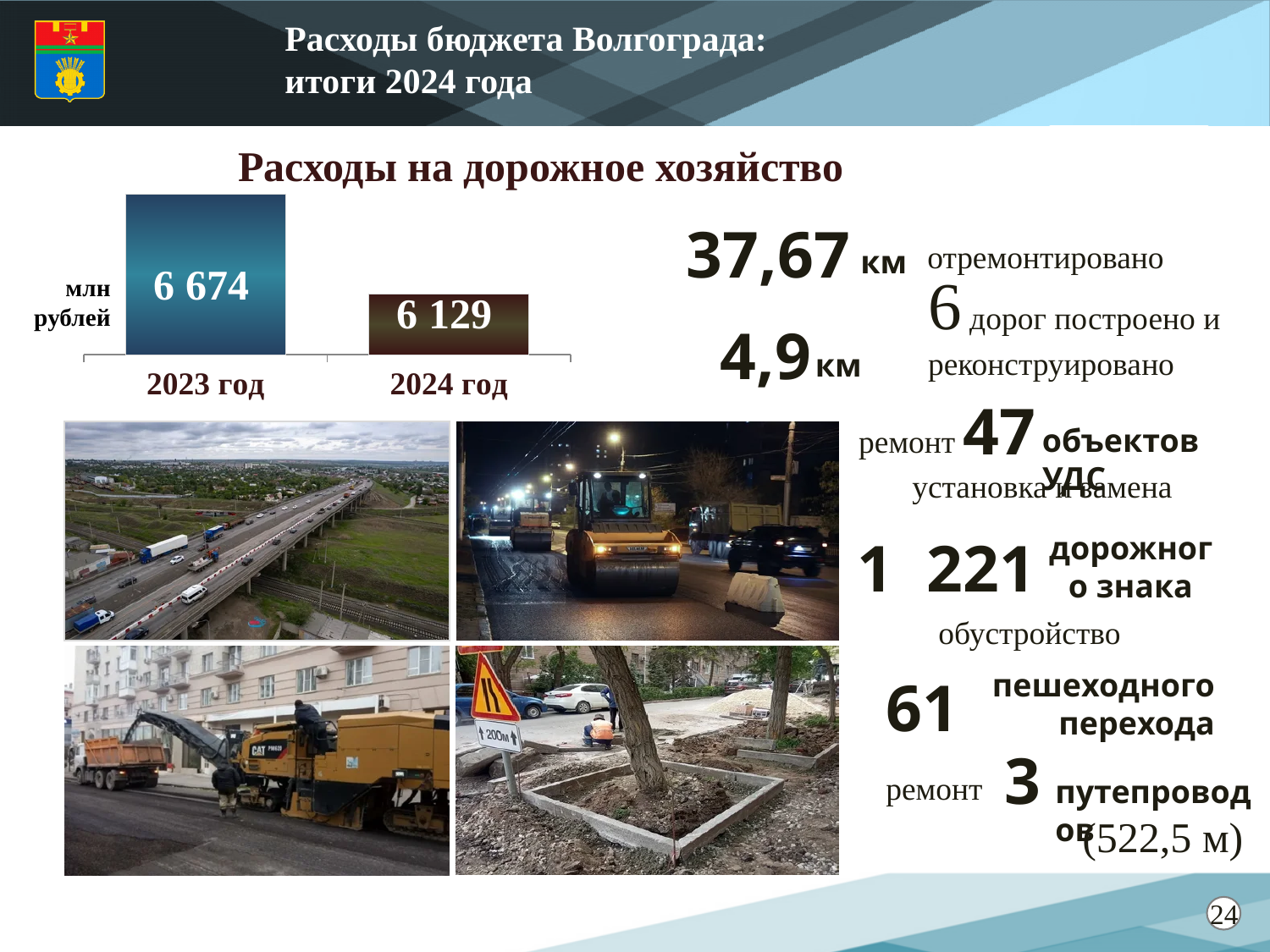
Do the values rise or fall from 2023 год to 2024 год? fall What is the value for 2024 год in the chart? 6 129 What is the value for 2023 год in the chart? 6 674 In what units are the chart values given? млн рублей What is the title of the chart? Расходы на дорожное хозяйство What is the difference between the 2023 год and 2024 год values in the chart? 545 Which year has the higher value in the chart? 2023 год What kind of chart is shown on the slide? bar chart Which year has the lower value in the chart? 2024 год Is the value for 2023 год larger or smaller than the value for 2024 год? larger How many bars does the chart show? 2